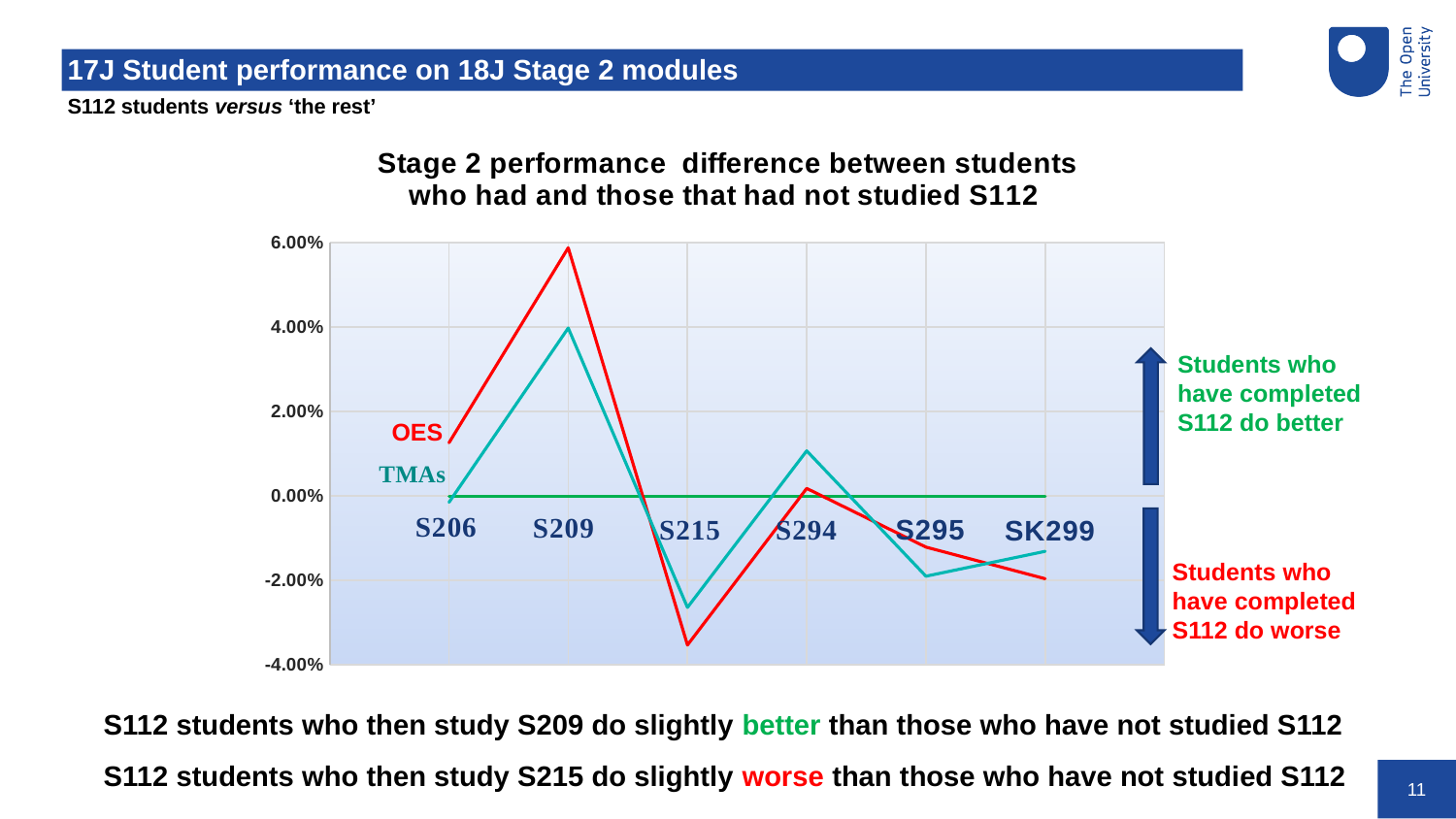
Is the TMAs value for S215 greater or less than -2.00%? less For which module does the TMAs line reach its highest value? S209 Is the OES value for S209 greater or less than 4.00%? greater Between S209 and S215, does the OES line rise or fall? fall Which colour is used for the OES line? red For which module does the OES line reach its lowest value? S215 What kind of chart is shown on the slide? line chart How many modules are plotted along the x axis of the chart? 6 For which module does the OES line reach its highest value? S209 Is the OES value for S215 greater or less than -2.00%? less How many series are plotted on the chart? 3 At S209, which series has the larger value, OES or TMAs? OES